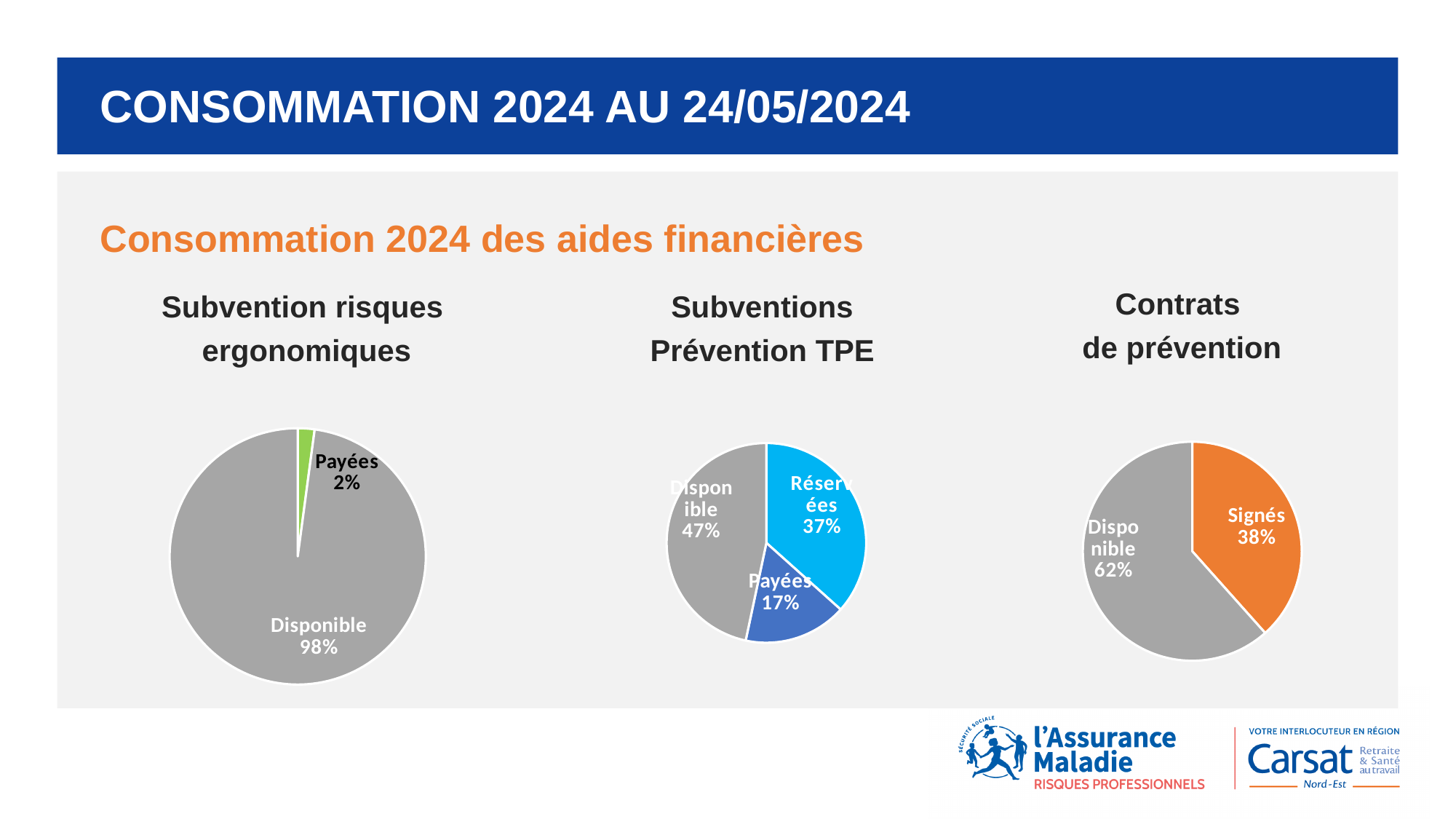
In the 'Subventions Prévention TPE' chart, what share is labelled Réservées? 37% In the 'Subventions Prévention TPE' chart, which slice is the smallest? Payées In the 'Contrats de prévention' chart, what share is labelled Signés? 38% In the 'Subventions Prévention TPE' chart, which slice is the largest? Disponible In the 'Subvention risques ergonomiques' chart, what share is labelled Payées? 2% In the 'Subventions Prévention TPE' chart, what share is labelled Disponible? 47% In the 'Contrats de prévention' chart, what is the difference in percentage points between Disponible and Signés? 24 In the 'Subvention risques ergonomiques' chart, what share is labelled Disponible? 98% In the 'Subventions Prévention TPE' chart, what share is labelled Payées? 17% How many slices does the 'Subventions Prévention TPE' chart have? 3 What type of chart is used for 'Contrats de prévention'? Pie chart In the 'Contrats de prévention' chart, what share is labelled Disponible? 62%